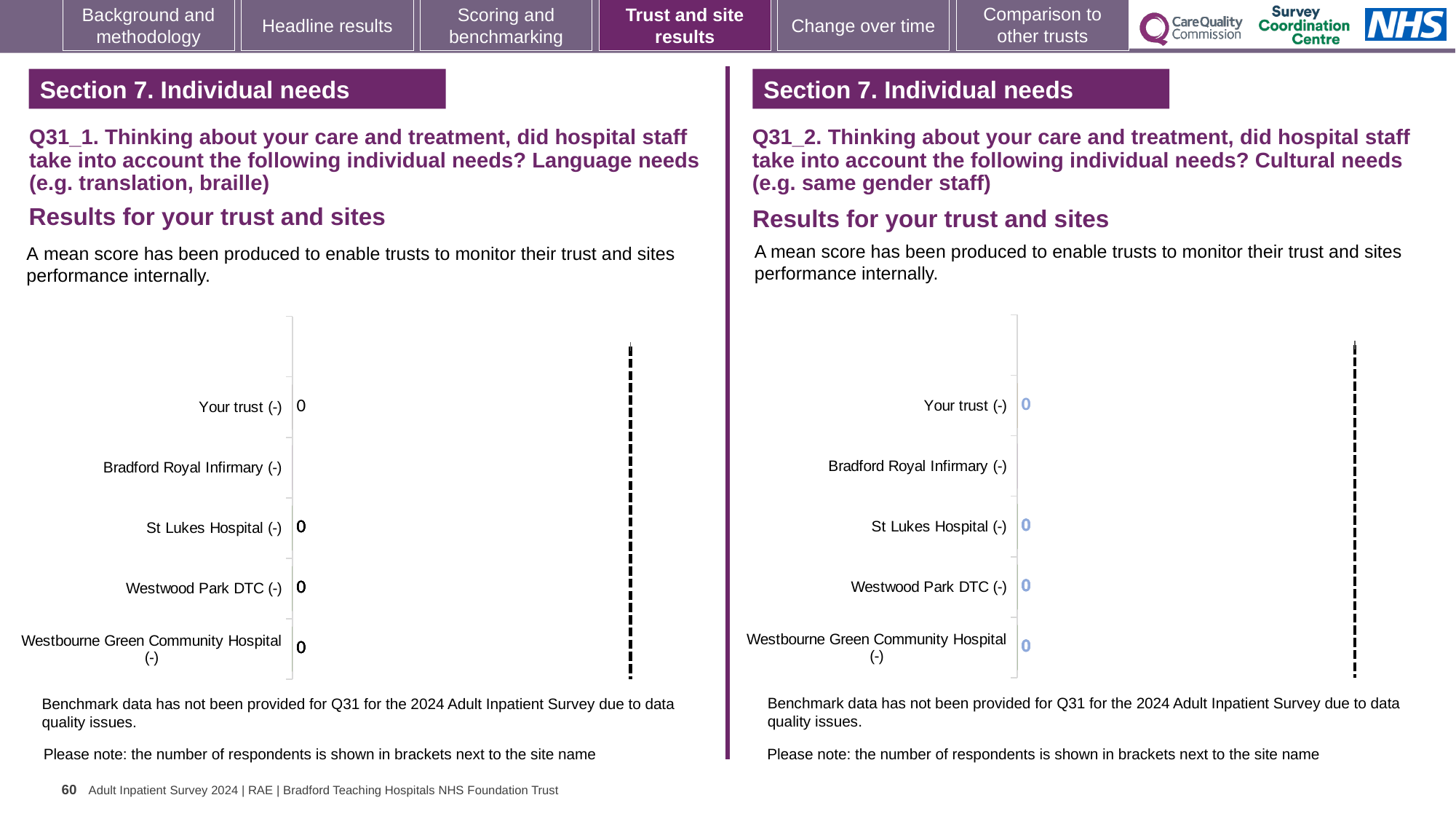
Which question number does the left chart relate to? Q31_1 On the right chart (Q31_2, Cultural needs), which category has no data label shown next to it? Bradford Royal Infirmary (-) On the left chart (Q31_1, Language needs), what is the value shown for Westbourne Green Community Hospital? 0 On the left chart (Q31_1, Language needs), what is the value shown for St Lukes Hospital? 0 On the left chart (Q31_1, Language needs), what is the value shown for Your trust? 0 On the right chart (Q31_2, Cultural needs), what is the value shown for Your trust? 0 How many categories are listed on the y axis of the left chart (Q31_1, Language needs)? 5 On the right chart (Q31_2, Cultural needs), what is the value shown for Westbourne Green Community Hospital? 0 How many categories are listed on the y axis of the right chart (Q31_2, Cultural needs)? 5 What kind of chart is the left chart (Q31_1, Language needs)? Bar chart On the right chart (Q31_2, Cultural needs), what is the value shown for St Lukes Hospital? 0 On the left chart (Q31_1, Language needs), what is the value shown for Westwood Park DTC? 0